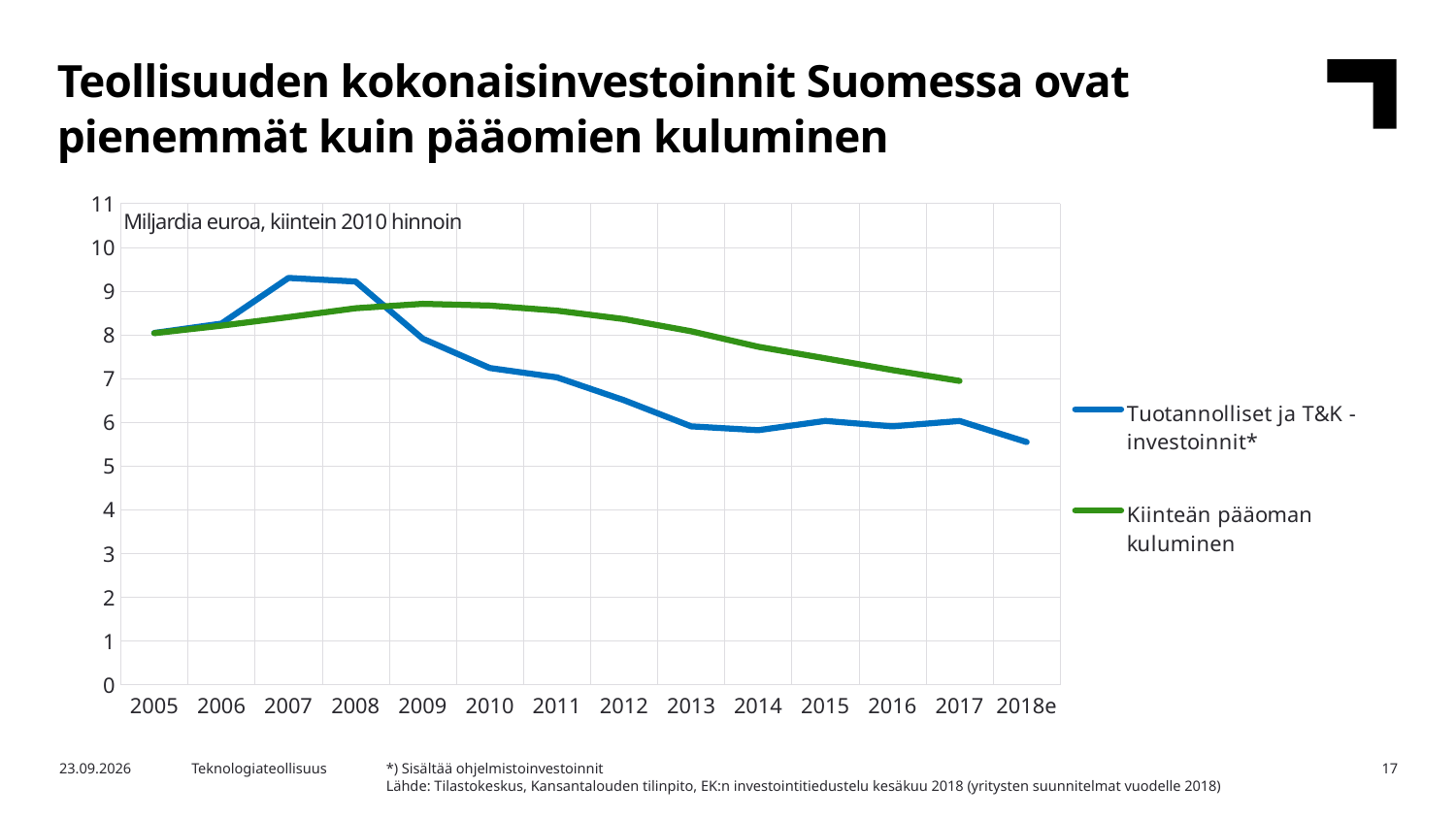
What kind of chart is shown on the slide? line chart What unit is stated inside the chart area? Miljardia euroa, kiintein 2010 hinnoin Does Kiinteän pääoman kuluminen rise or fall from 2009 to 2017? fall Is the value for Tuotannolliset ja T&K -investoinnit* in 2007 greater or less than 9? greater Is the value for Tuotannolliset ja T&K -investoinnit* in 2018e greater or less than 6? less In 2007, which series has the higher value: Tuotannolliset ja T&K -investoinnit* or Kiinteän pääoman kuluminen? Tuotannolliset ja T&K -investoinnit* Is the value for Kiinteän pääoman kuluminen in 2017 greater or less than 8? less In which year is Tuotannolliset ja T&K -investoinnit* at its lowest? 2018e How many series does the legend list? 2 In 2012, which series has the higher value: Tuotannolliset ja T&K -investoinnit* or Kiinteän pääoman kuluminen? Kiinteän pääoman kuluminen How many years are shown on the x axis? 14